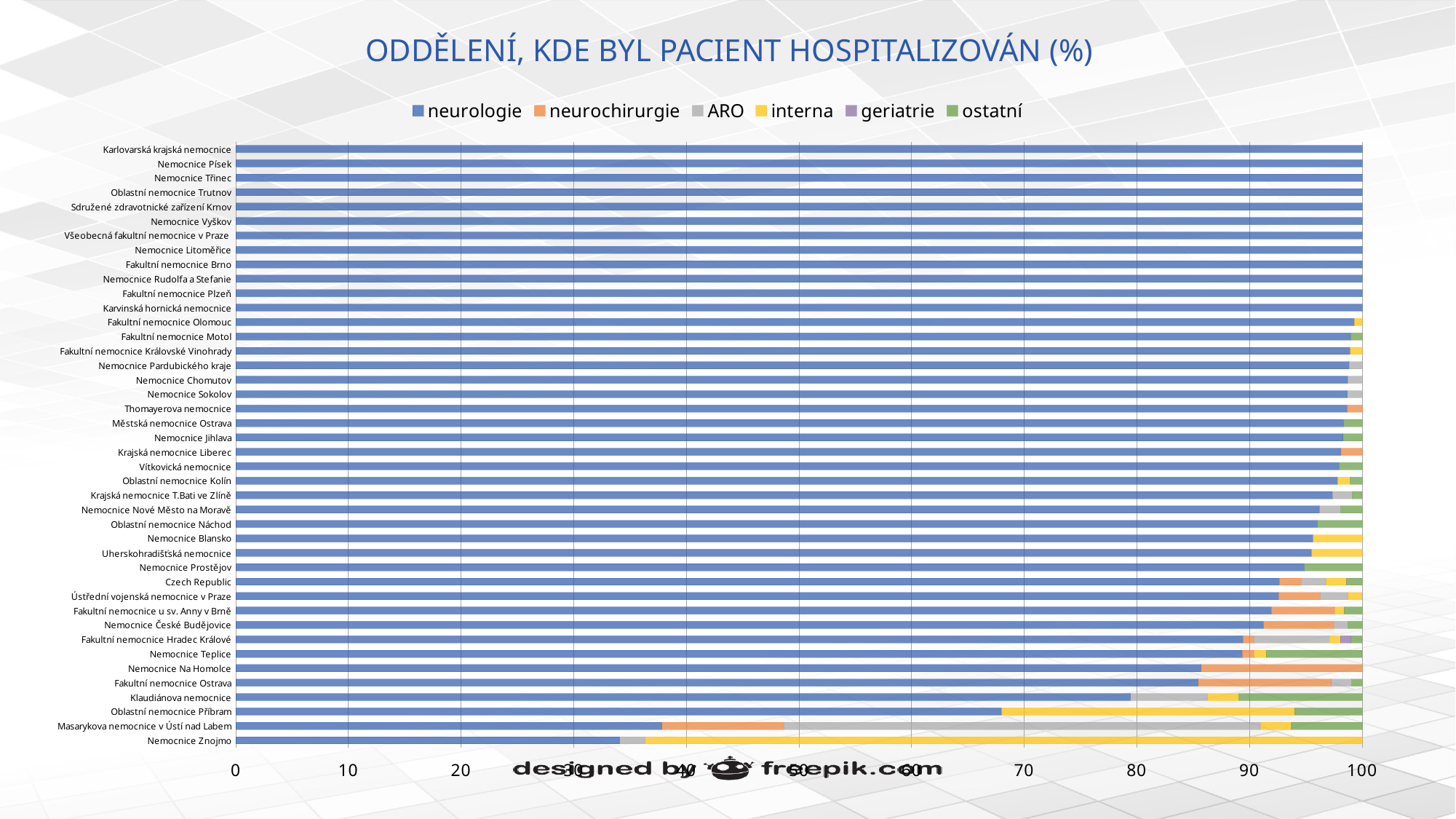
Is the neurologie value for Nemocnice Znojmo greater or less than 40? less Is the neurologie value for Oblastní nemocnice Příbram greater or less than 60? greater What kind of chart is shown on the slide? Stacked bar chart What is the total of the stacked bar for Nemocnice Znojmo? 100 Which hospital has the lowest neurologie share? Nemocnice Znojmo Which colour represents the interna series in the legend? Yellow How many hospitals (categories) are plotted on the chart? 42 Is the neurologie value for Nemocnice Na Homolce greater or less than 80? greater What is the title of the chart? ODDĚLENÍ, KDE BYL PACIENT HOSPITALIZOVÁN (%) How many series does the legend list? 6 Which has the larger neurologie share, Nemocnice Znojmo or Oblastní nemocnice Příbram? Oblastní nemocnice Příbram